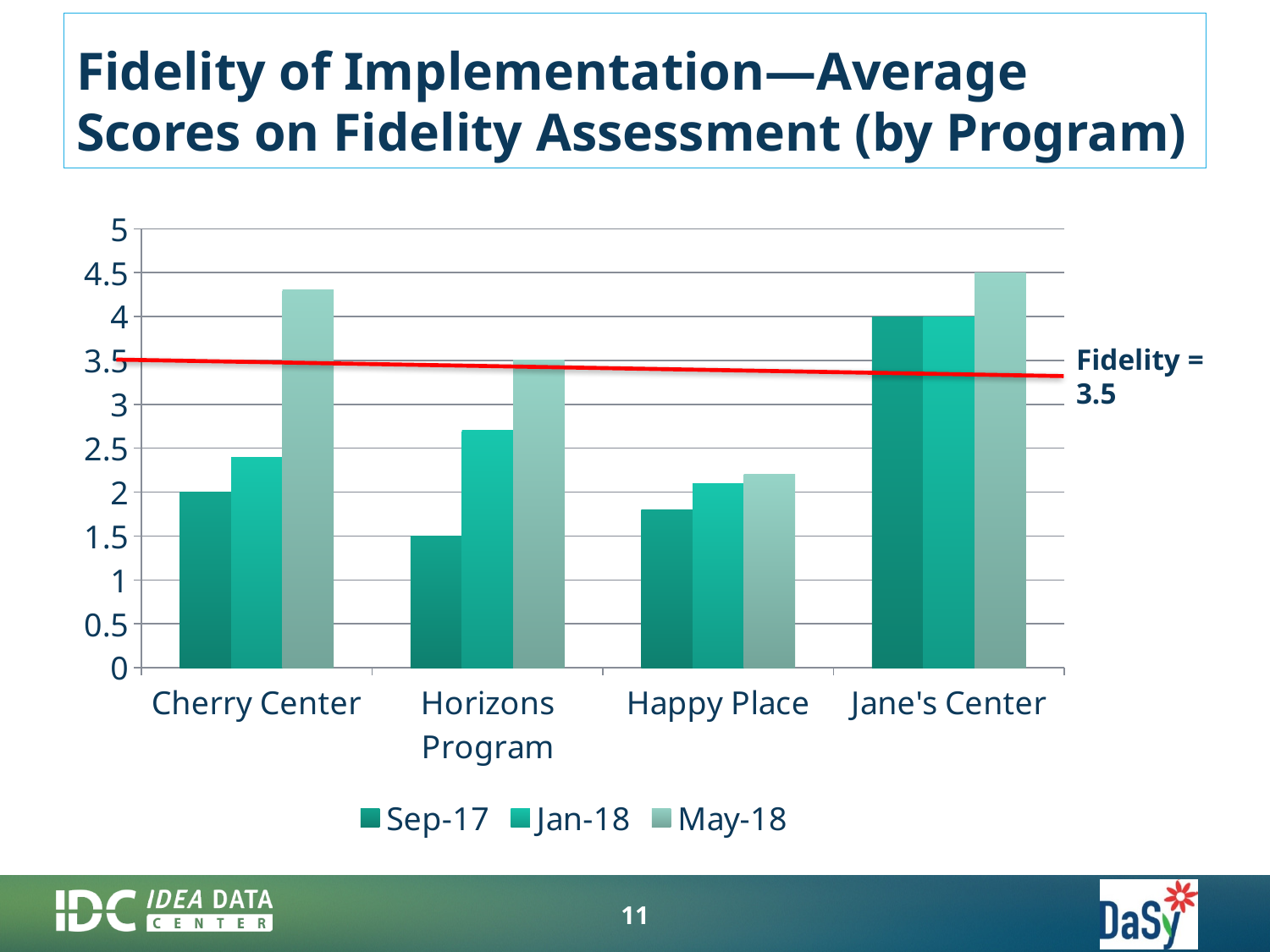
What is the Sep-17 score for Horizons Program? 1.5 What is the Sep-17 score for Cherry Center? 2 Which program has the lowest Sep-17 score? Horizons Program Is the May-18 value for Happy Place greater or less than 2.5? less Which program has the highest May-18 score? Jane's Center Is the May-18 value for Cherry Center greater or less than 4? greater What is the Jan-18 score for Jane's Center? 4 How many series does the chart's legend list? 3 What type of chart is shown on the slide? bar chart How many programs are shown on the x axis of the chart? 4 What value does the red horizontal line on the chart represent? Fidelity = 3.5 What is the May-18 score for Jane's Center? 4.5